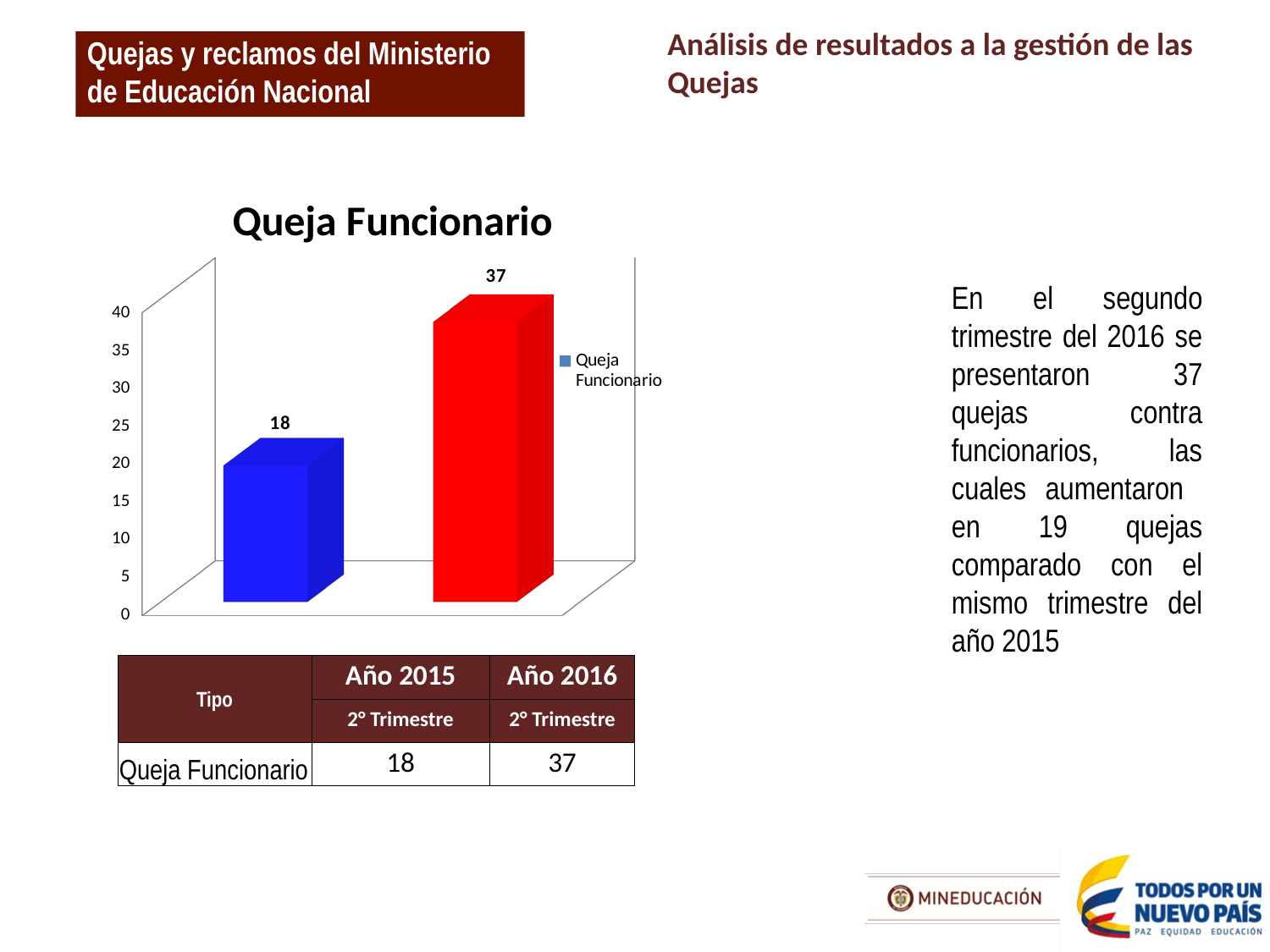
What is the title of the chart on the slide? Queja Funcionario What is the value shown on the blue (left) bar in the Queja Funcionario chart? 18 What is the value shown on the red (right) bar in the Queja Funcionario chart? 37 How many bars are plotted in the Queja Funcionario chart? 2 What is the difference between the values of the red bar and the blue bar in the Queja Funcionario chart? 19 How many series does the legend of the Queja Funcionario chart list? 1 Which bar in the Queja Funcionario chart is the highest, the blue one or the red one? the red one Is the value of the red bar in the Queja Funcionario chart greater or less than 35? greater Do the values in the Queja Funcionario chart rise or fall from the left bar to the right bar? rise Which bar in the Queja Funcionario chart is the lowest, the blue one or the red one? the blue one What kind of chart is the Queja Funcionario chart? bar chart Is the value of the blue bar in the Queja Funcionario chart greater or less than 20? less